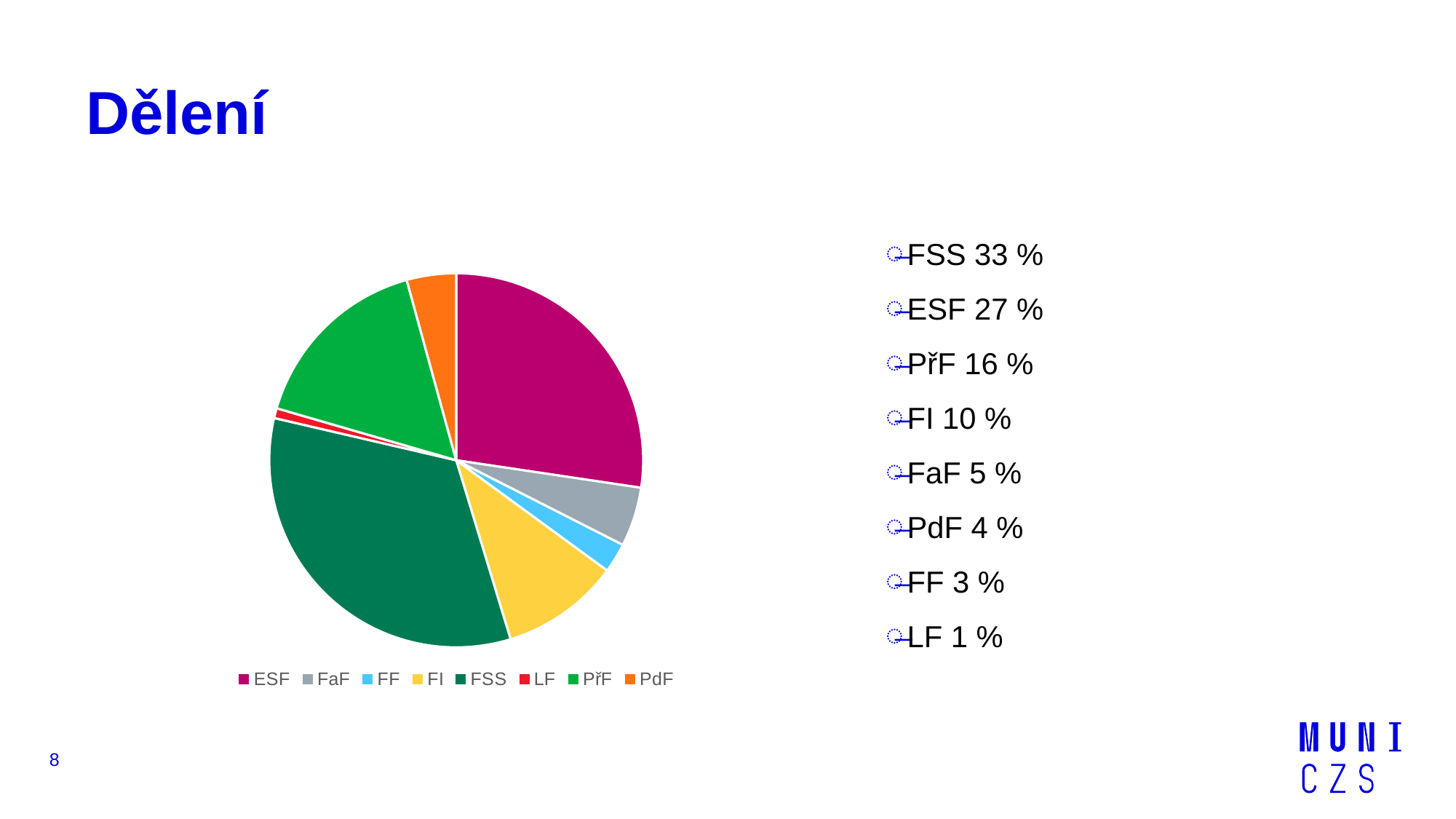
What share of the pie does FI represent? 10 % What kind of chart is shown on the slide? pie chart Which category has the smallest slice of the pie chart? LF What share of the pie does FSS represent? 33 % Which slice is larger, FaF or PdF? FaF What share of the pie does PřF represent? 16 % What is the difference in percentage points between the FSS and ESF shares? 6 Which category has the largest slice of the pie chart? FSS What is the difference in percentage points between the PřF and FI shares? 6 How many slices does the pie chart have? 8 What colour is the FSS slice in the pie chart? dark green